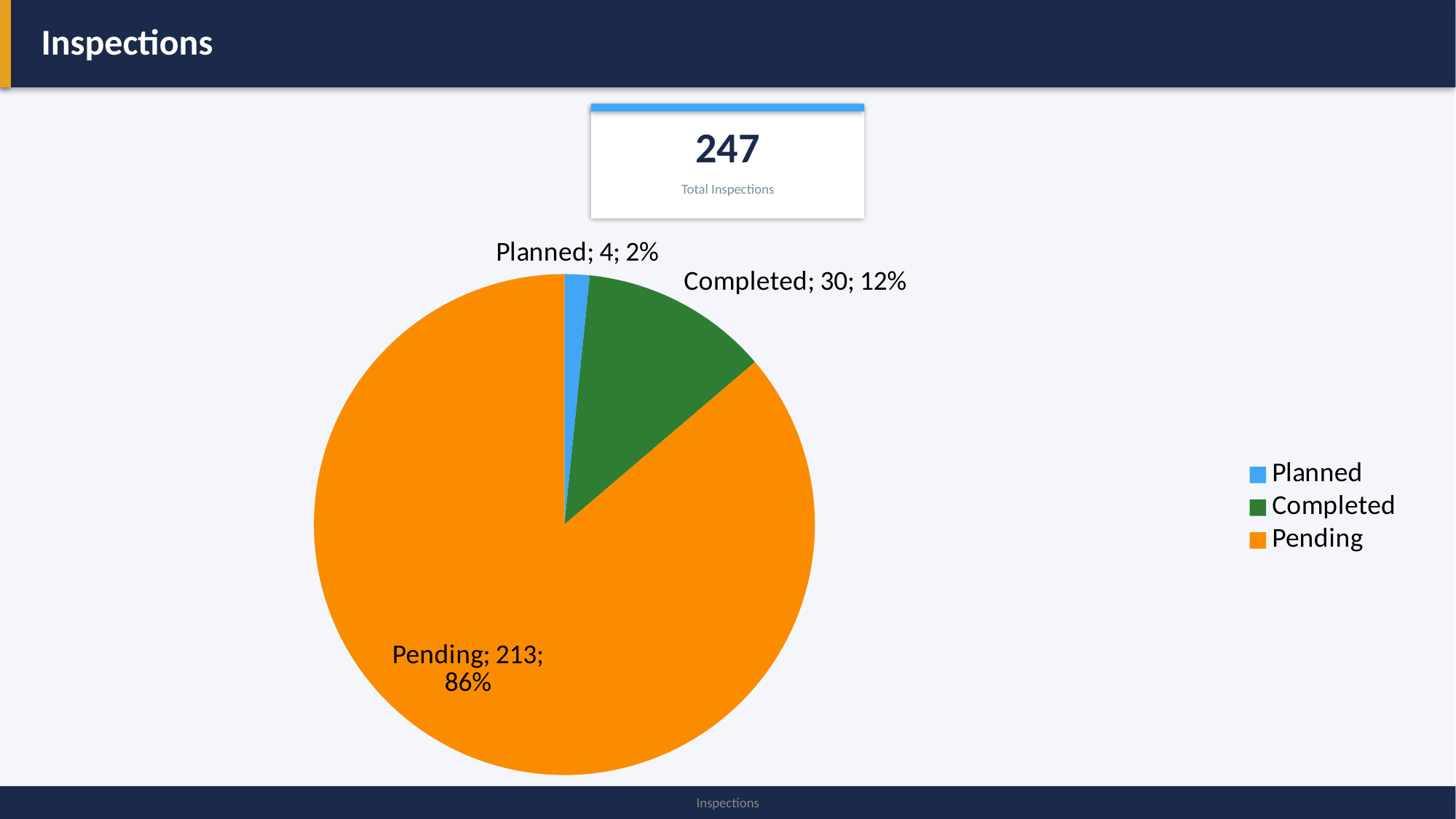
What is the difference between the Pending and Completed counts? 183 What type of chart is shown on the slide? pie chart How many inspections are Completed? 30 Which is larger, the Completed count or the Planned count? Completed Which category has the smallest slice of the pie? Planned How many inspections are Pending? 213 How many inspections are Planned? 4 Which category has the largest slice of the pie? Pending What colour is the Pending slice? orange How many categories does the pie chart have? 3 What share of the pie does the Completed slice represent? 12% What share of the pie does the Pending slice represent? 86%